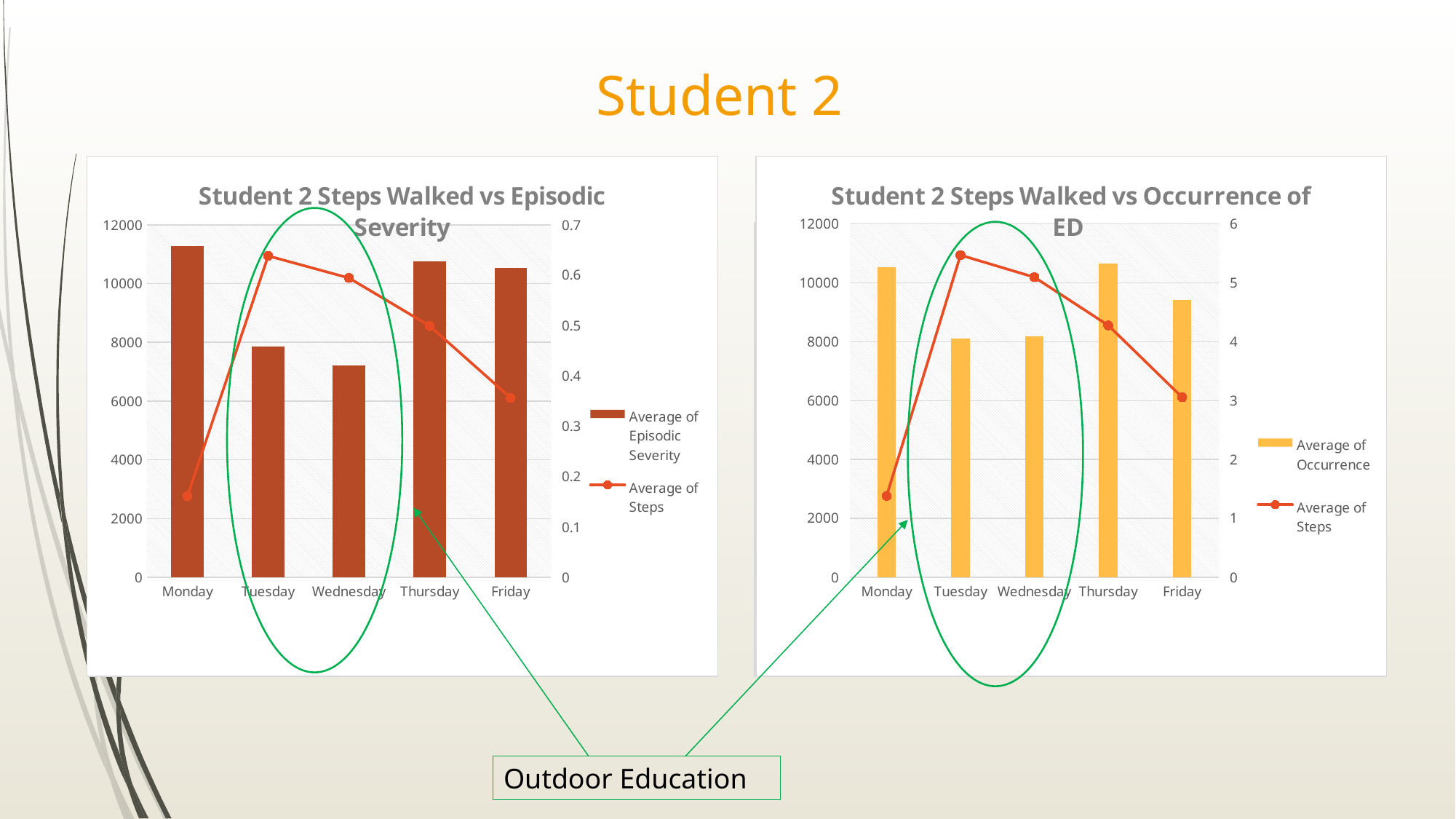
In the left chart, 'Student 2 Steps Walked vs Episodic Severity', how many days are shown on the x axis? 5 In the right chart, 'Student 2 Steps Walked vs Occurrence of ED', on which day does the line series reach its highest point? Tuesday In the right chart, 'Student 2 Steps Walked vs Occurrence of ED', how many series does the legend list? 2 What kind of chart is the right chart, 'Student 2 Steps Walked vs Occurrence of ED'? Combination bar and line chart In the left chart, 'Student 2 Steps Walked vs Episodic Severity', which day has the tallest bar? Monday In the left chart, 'Student 2 Steps Walked vs Episodic Severity', on which day does the line series reach its highest point? Tuesday In the left chart, 'Student 2 Steps Walked vs Episodic Severity', on which day is the line series at its lowest point? Monday In the right chart, 'Student 2 Steps Walked vs Occurrence of ED', does the line series rise or fall from Tuesday to Friday? fall In the left chart, 'Student 2 Steps Walked vs Episodic Severity', which day has the shortest bar? Wednesday